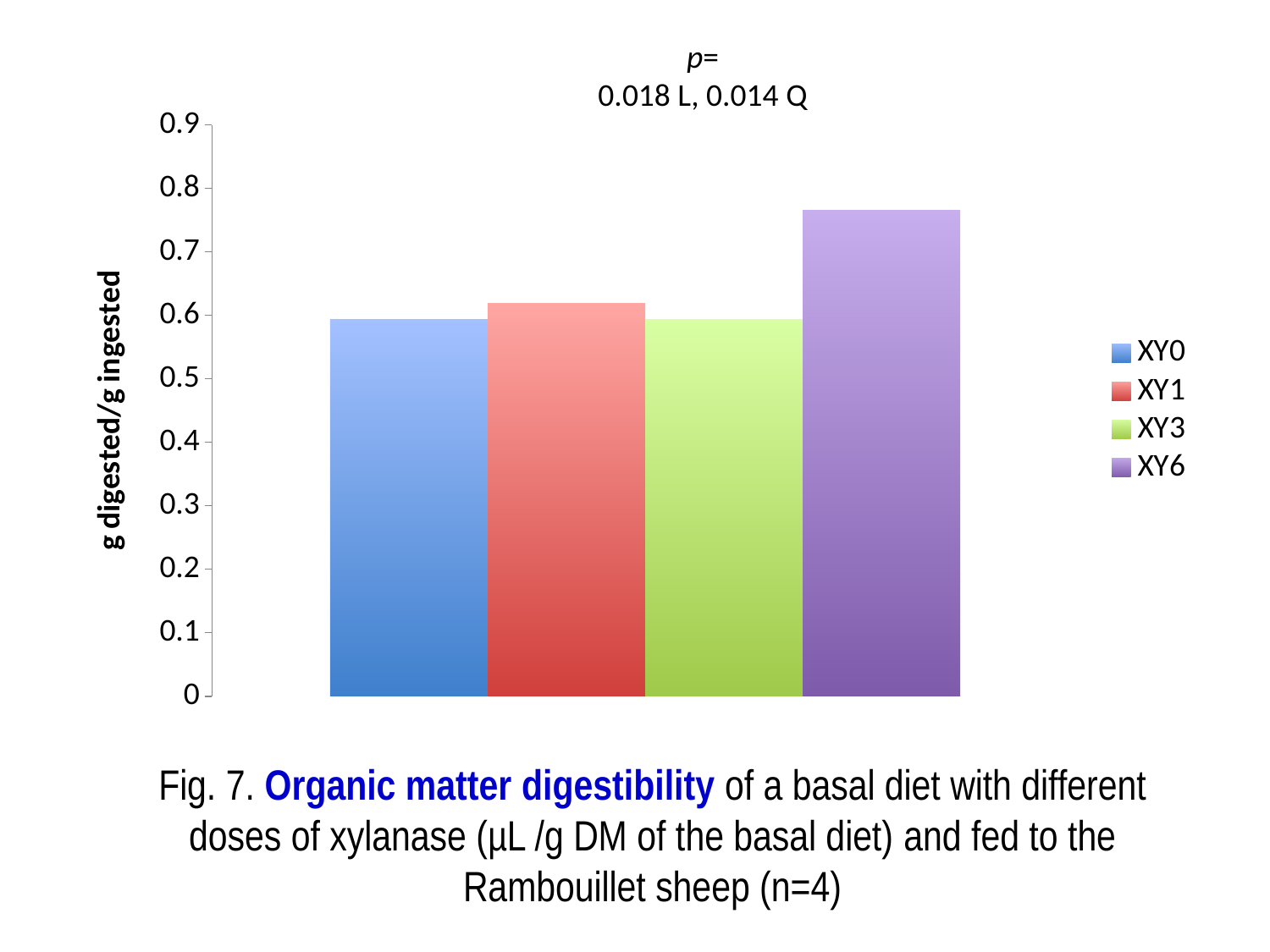
Is the value for XY3 greater or less than 0.7? less Which has the larger value, XY6 or XY1? XY6 What is the label on the vertical axis of the chart? g digested/g ingested How many series does the legend list? 4 What kind of chart is shown on the slide? bar chart Is the value for XY6 greater or less than 0.7? greater Is the value for XY0 greater or less than 0.5? greater What p-values are printed above the chart? 0.018 L, 0.014 Q Which has the larger value, XY1 or XY0? XY1 How many bars are plotted in the chart? 4 Which series has the highest value in the chart? XY6